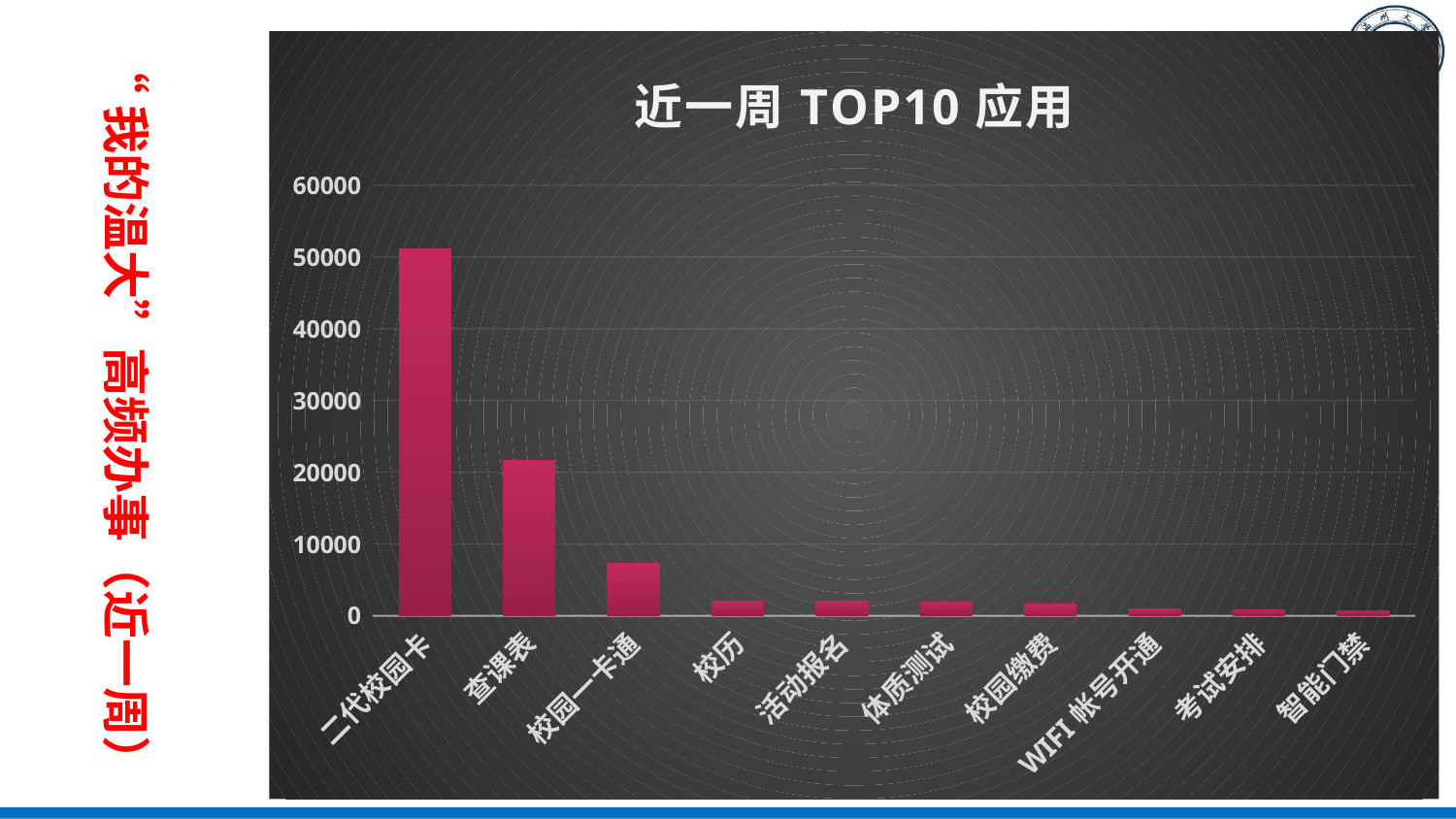
Is the value for 校历 greater or less than 10000? less Which is larger, the value for 校园一卡通 or the value for 活动报名? 校园一卡通 How many categories are plotted in the chart? 10 What is the highest value shown on the vertical axis? 60000 Is the value for 查课表 greater or less than 20000? greater Do the values rise or fall from left to right along the x axis? fall What is the title of the chart? 近一周 TOP10 应用 Is the value for 校园一卡通 greater or less than 10000? less Which is larger, the value for 二代校园卡 or the value for 查课表? 二代校园卡 What kind of chart is shown on the slide? bar chart Which category has the highest value? 二代校园卡